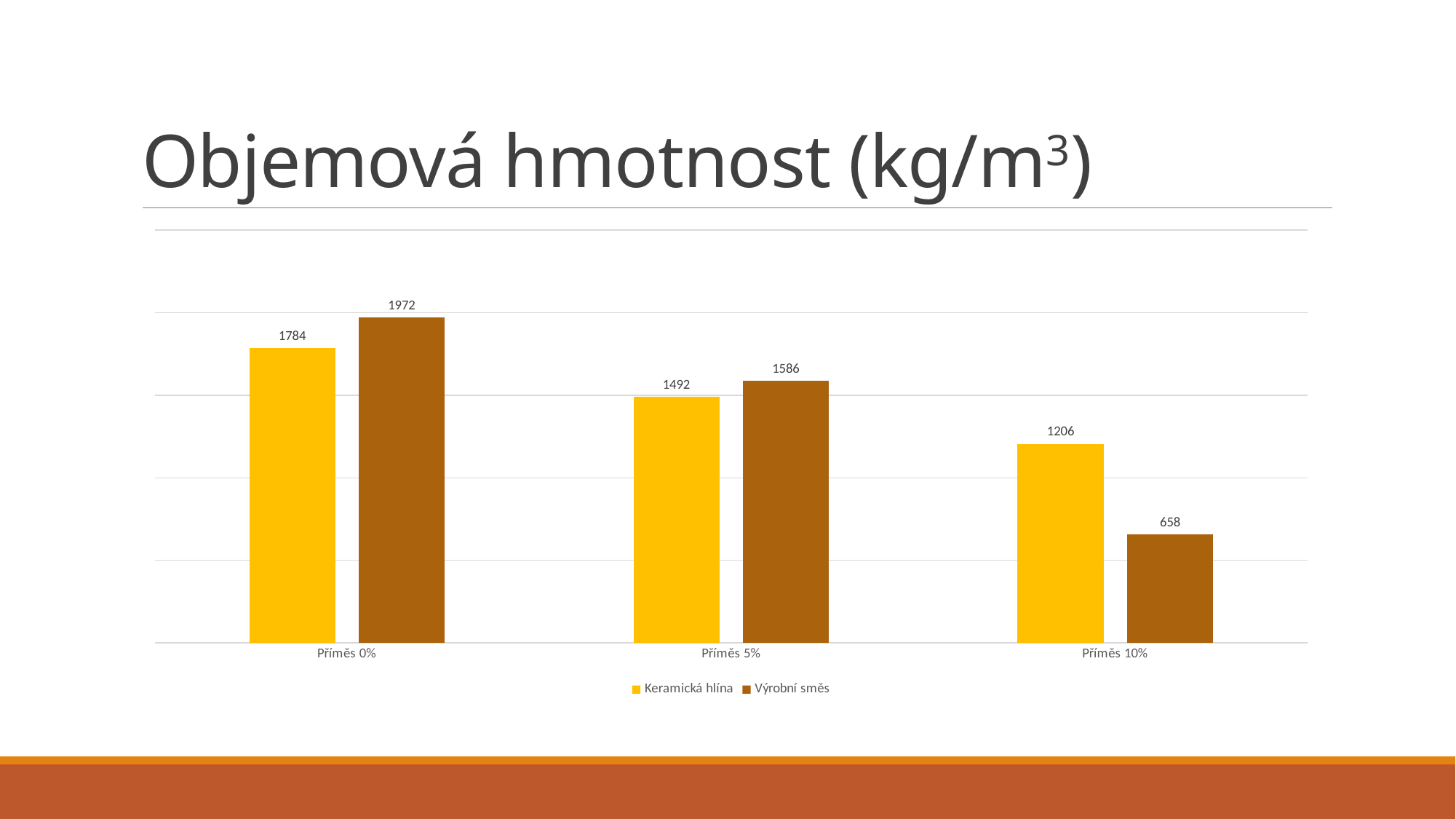
At Příměs 5%, which series has the larger value, Keramická hlína or Výrobní směs? Výrobní směs What is the value for Výrobní směs at Příměs 10%? 658 Do the values for Keramická hlína rise or fall from Příměs 0% to Příměs 10%? Fall What is the difference between Výrobní směs and Keramická hlína at Příměs 0%? 188 What is the difference between Keramická hlína and Výrobní směs at Příměs 10%? 548 Which category has the lowest value for Keramická hlína? Příměs 10% Which category has the highest value for Výrobní směs? Příměs 0% How many series does the legend list? 2 How many categories are shown on the x axis? 3 What kind of chart is shown on the slide? Bar chart What is the value for Výrobní směs at Příměs 5%? 1586 What is the value for Keramická hlína at Příměs 0%? 1784